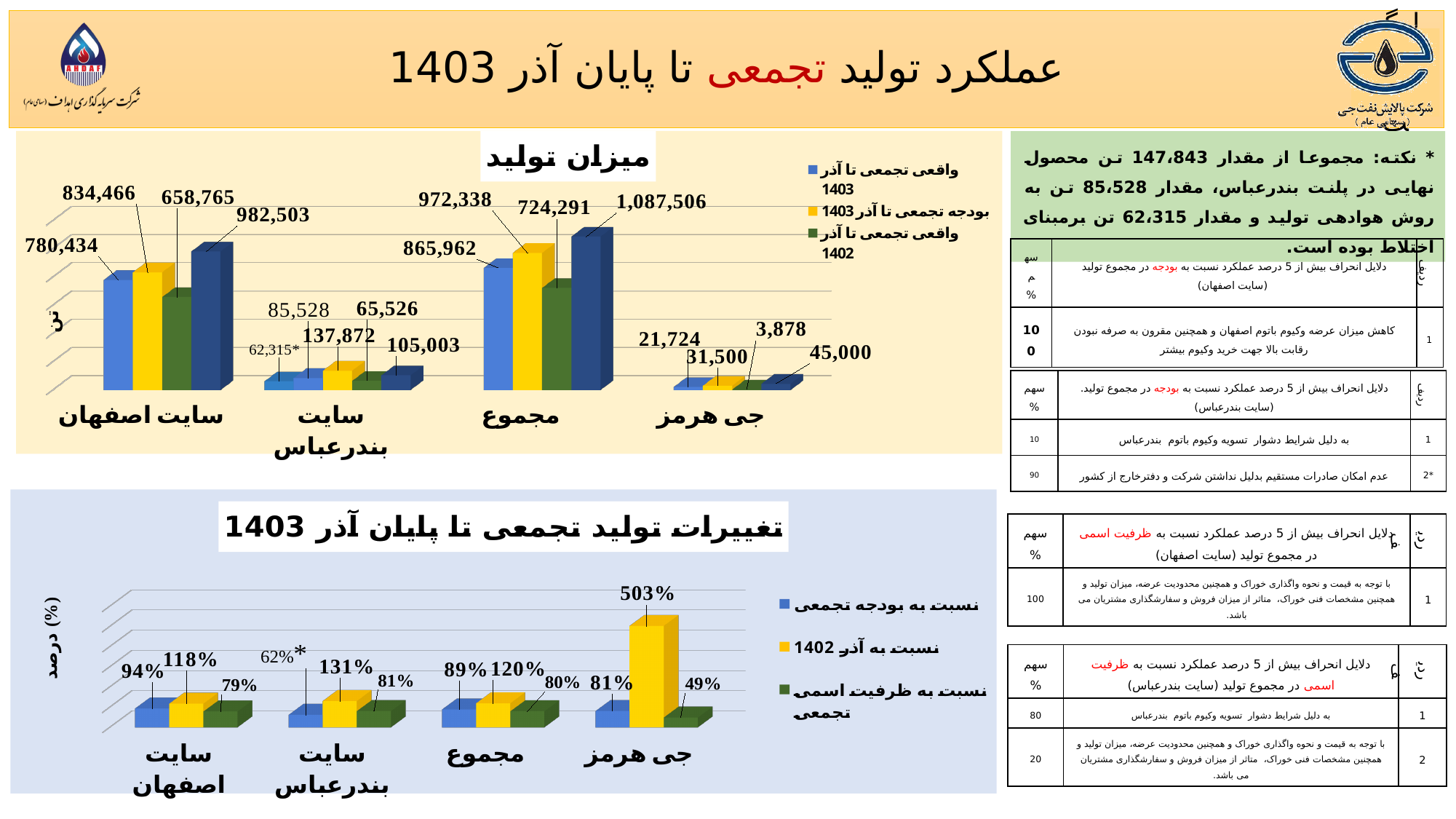
In the top chart (میزان تولید), which category has the lowest value for واقعی تجمعی تا آذر 1403? جی هرمز What kind of chart is the bottom chart (تغییرات تولید تجمعی تا پایان آذر 1403)? bar chart In the top chart (میزان تولید), what is the value of بودجه تجمعی تا آذر 1403 for سایت اصفهان? 834,466 In the bottom chart (تغییرات تولید تجمعی تا پایان آذر 1403), which category has the lowest value for نسبت به ظرفیت اسمی تجمعی? جی هرمز In the top chart (میزان تولید), what is the difference between بودجه تجمعی تا آذر 1403 and واقعی تجمعی تا آذر 1403 for سایت اصفهان? 54,032 How many categories are shown on the x axis of the top chart (میزان تولید)? 4 In the top chart (میزان تولید), what is the value of واقعی تجمعی تا آذر 1403 for مجموع? 865,962 In the bottom chart (تغییرات تولید تجمعی تا پایان آذر 1403), what is the value of نسبت به آذر 1402 for جی هرمز? 503% In the top chart (میزان تولید), for سایت اصفهان, which is larger: واقعی تجمعی تا آذر 1403 or واقعی تجمعی تا آذر 1402? واقعی تجمعی تا آذر 1403 In the top chart (میزان تولید), what is the value of واقعی تجمعی تا آذر 1402 for جی هرمز? 3,878 How many series does the legend of the top chart (میزان تولید) list? 3 In the top chart (میزان تولید), which category has the highest value for بودجه تجمعی تا آذر 1403? مجموع